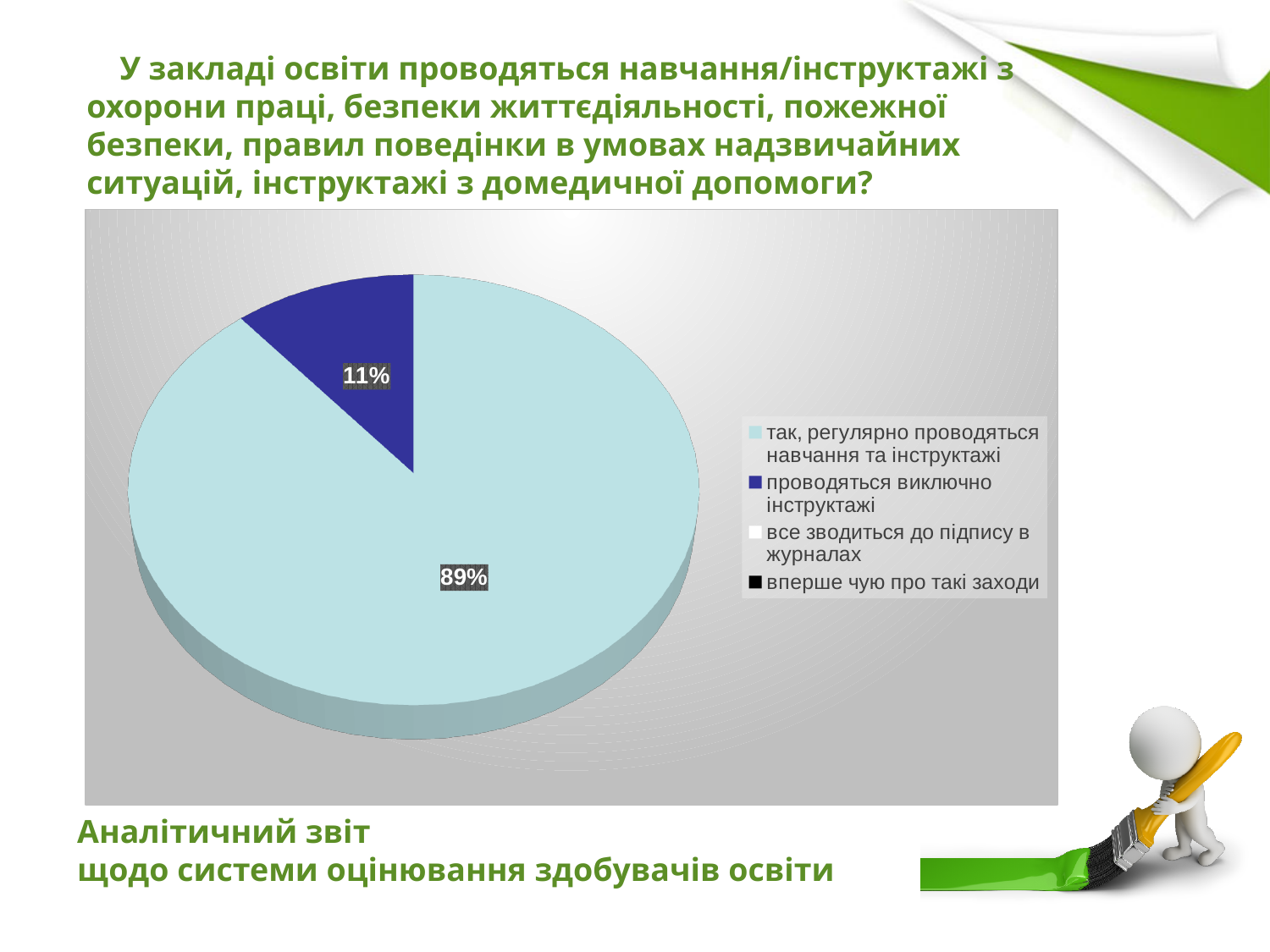
What share of the pie does "так, регулярно проводяться навчання та інструктажі" have? 89% How many slices of the pie have a visible data label? 2 Which of the two labelled slices is smaller, "так, регулярно проводяться навчання та інструктажі" or "проводяться виключно інструктажі"? проводяться виключно інструктажі Is the share for "проводяться виключно інструктажі" greater or less than 50%? less Which category has the largest slice of the pie? так, регулярно проводяться навчання та інструктажі What colour is the slice labelled 89%? light blue What is the difference in percentage points between the 89% slice and the 11% slice? 78 What kind of chart is shown on the slide? pie chart What share of the pie does "проводяться виключно інструктажі" have? 11% What colour is the slice labelled 11%? dark blue How many entries does the legend list? 4 What is the combined share of the two labelled slices, 89% and 11%? 100%